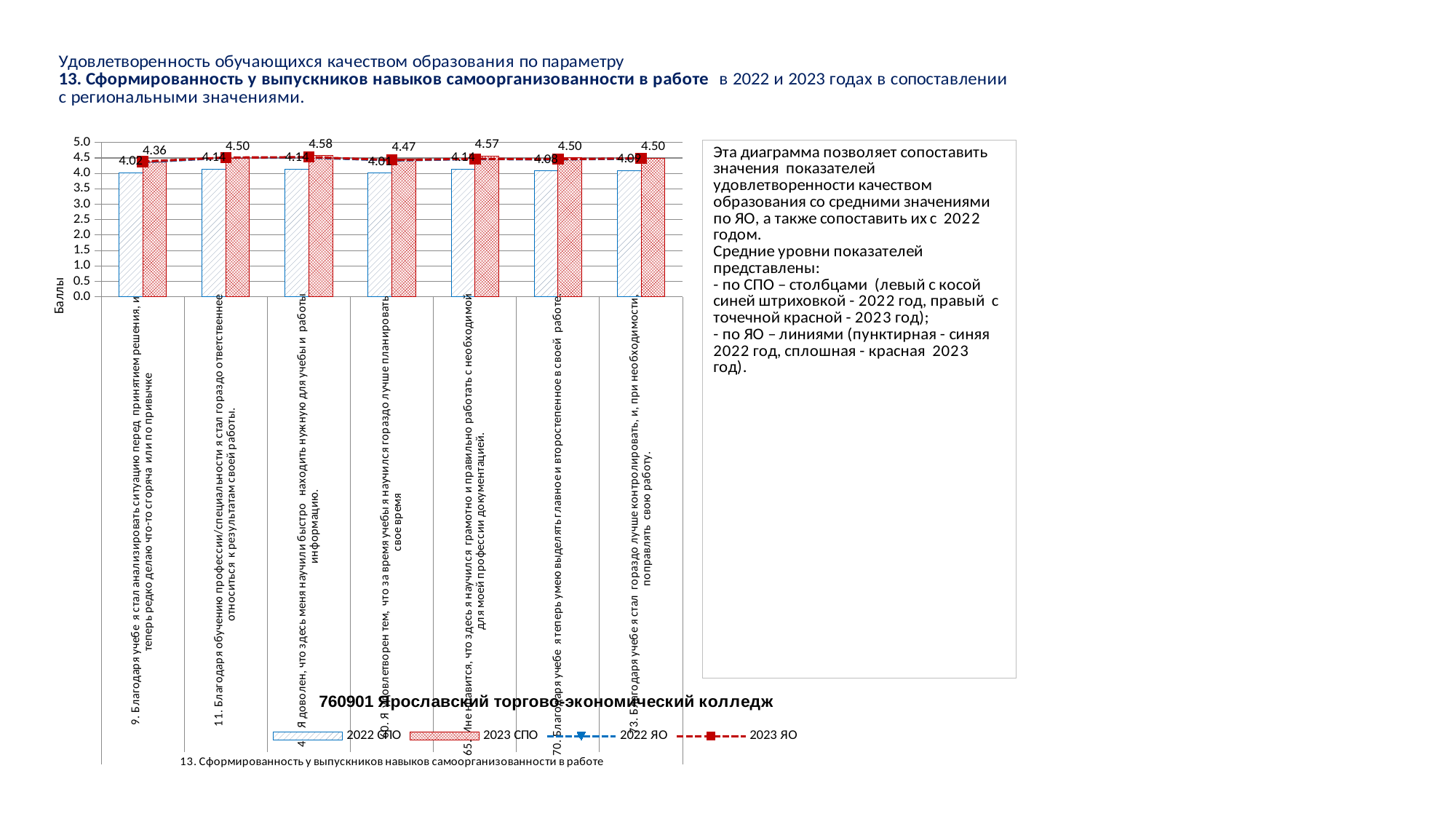
How many series does the chart legend list? 4 What is the label on the vertical axis of the chart? Баллы What is the 2022 СПО value for statement 70 ("Благодаря учебе я теперь умею выделять главное и второстепенное в своей работе")? 4.08 What kind of chart is shown on the slide? A combined bar and line chart What is the difference between the 2023 СПО values for statement 11 (4.50) and statement 9 (4.36)? 0.14 Is the 2022 СПО value for statement 9 greater or less than 4.5? less Which statement has the lowest 2023 СПО value? Statement 9 ("Благодаря учебе я стал анализировать ситуацию перед принятием решения..."), 4.36 How many categories (statements) are plotted along the x axis of the chart? 7 For statement 70, which is larger: the 2022 СПО value or the 2023 СПО value? 2023 СПО (4.50) What is the 2023 СПО value for statement 11 ("Благодаря обучению профессии/специальности я стал гораздо ответственнее относиться к результатам своей работы")? 4.50 What is the 2023 СПО value for statement 65 ("Мне нравится, что здесь я научился грамотно и правильно работать с необходимой для моей профессии документацией")? 4.57